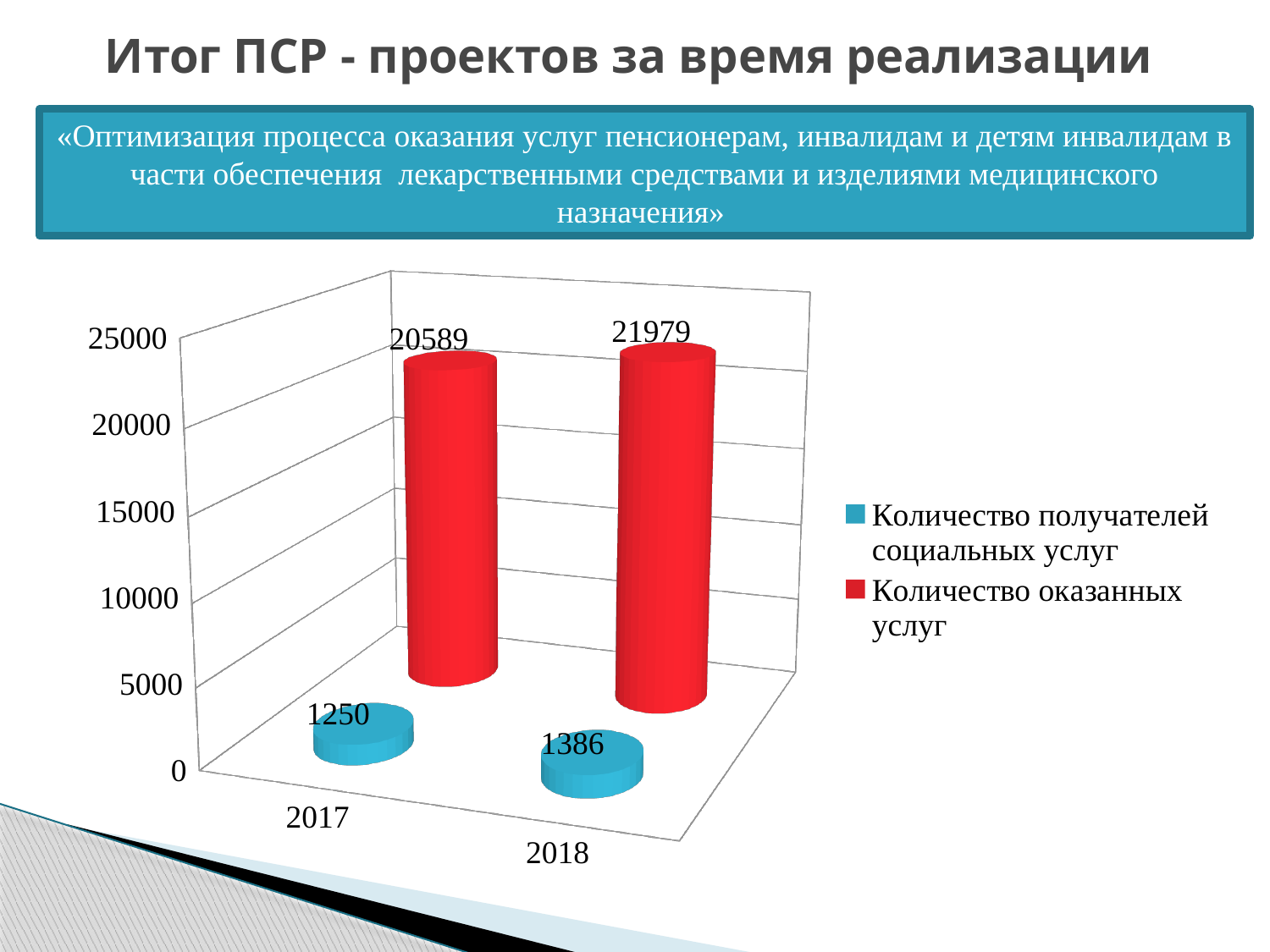
What is the value of "Количество получателей социальных услуг" for 2018? 1386 What kind of chart is shown on the slide? bar chart Which year has the higher value for "Количество оказанных услуг"? 2018 What is the value of "Количество оказанных услуг" for 2017? 20589 How many years are shown on the x axis of the chart? 2 What is the difference between the "Количество оказанных услуг" values for 2018 and 2017? 1390 Is the value for "Количество оказанных услуг" in 2017 greater or less than 20000? greater What is the value of "Количество оказанных услуг" for 2018? 21979 How many series does the legend list? 2 What is the difference between the "Количество получателей социальных услуг" values for 2018 and 2017? 136 What is the value of "Количество получателей социальных услуг" for 2017? 1250 Which year has the lower value for "Количество получателей социальных услуг"? 2017